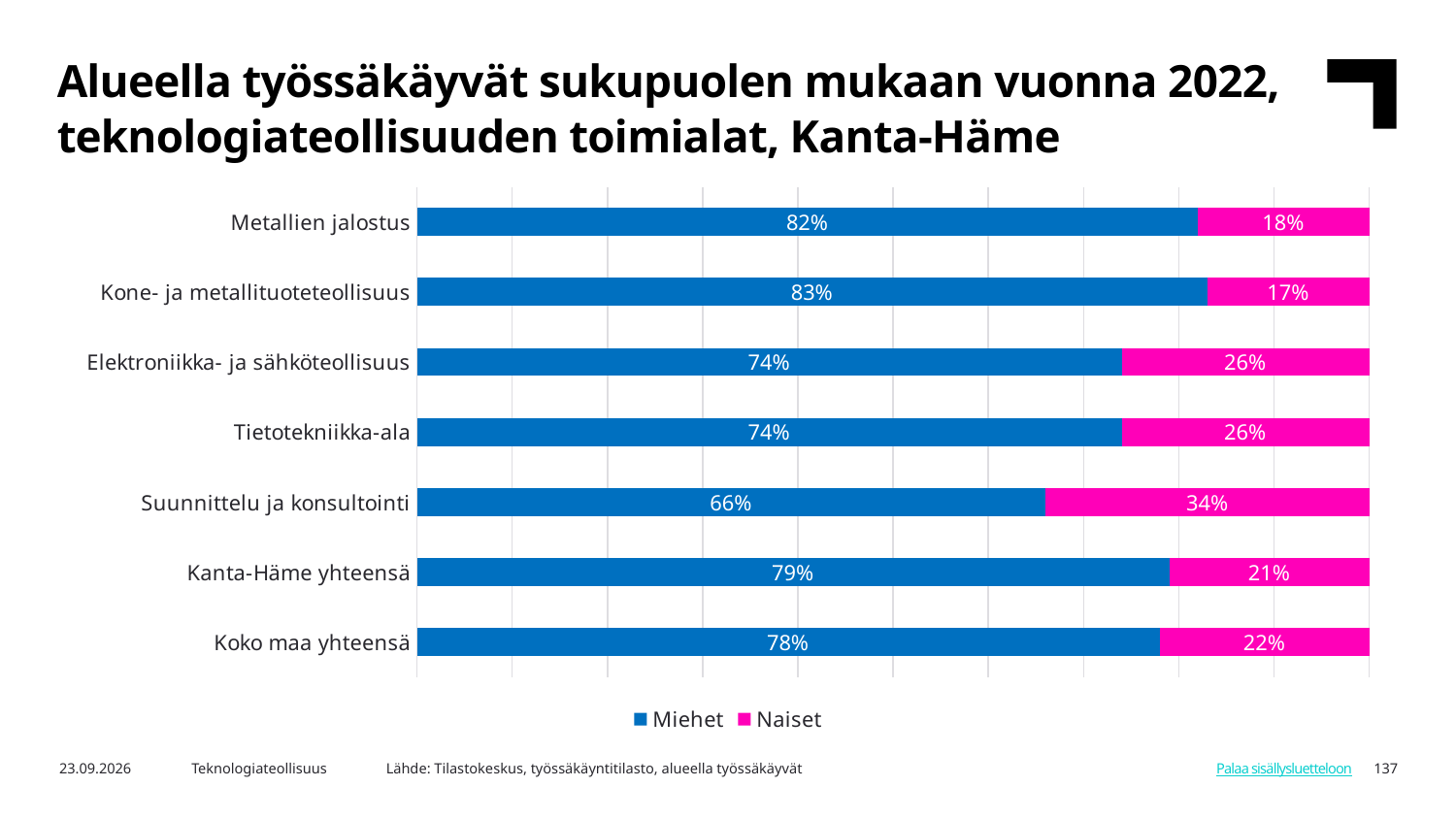
What is the Miehet share for Koko maa yhteensä? 78% What is the Miehet share for Metallien jalostus? 82% Which category has the highest Miehet share? Kone- ja metallituoteteollisuus Which is larger: the Naiset share for Kanta-Häme yhteensä or for Koko maa yhteensä? Koko maa yhteensä How many categories are shown on the chart? 7 What kind of chart is shown on the slide? Stacked bar chart What is the Naiset share for Suunnittelu ja konsultointi? 34% What is the total of the stacked bar for Tietotekniikka-ala? 100% What is the difference between the Naiset share for Suunnittelu ja konsultointi and the Naiset share for Metallien jalostus? 16 percentage points Which category has the lowest Miehet share? Suunnittelu ja konsultointi What is the Naiset share for Kone- ja metallituoteteollisuus? 17% How many series does the legend list? 2